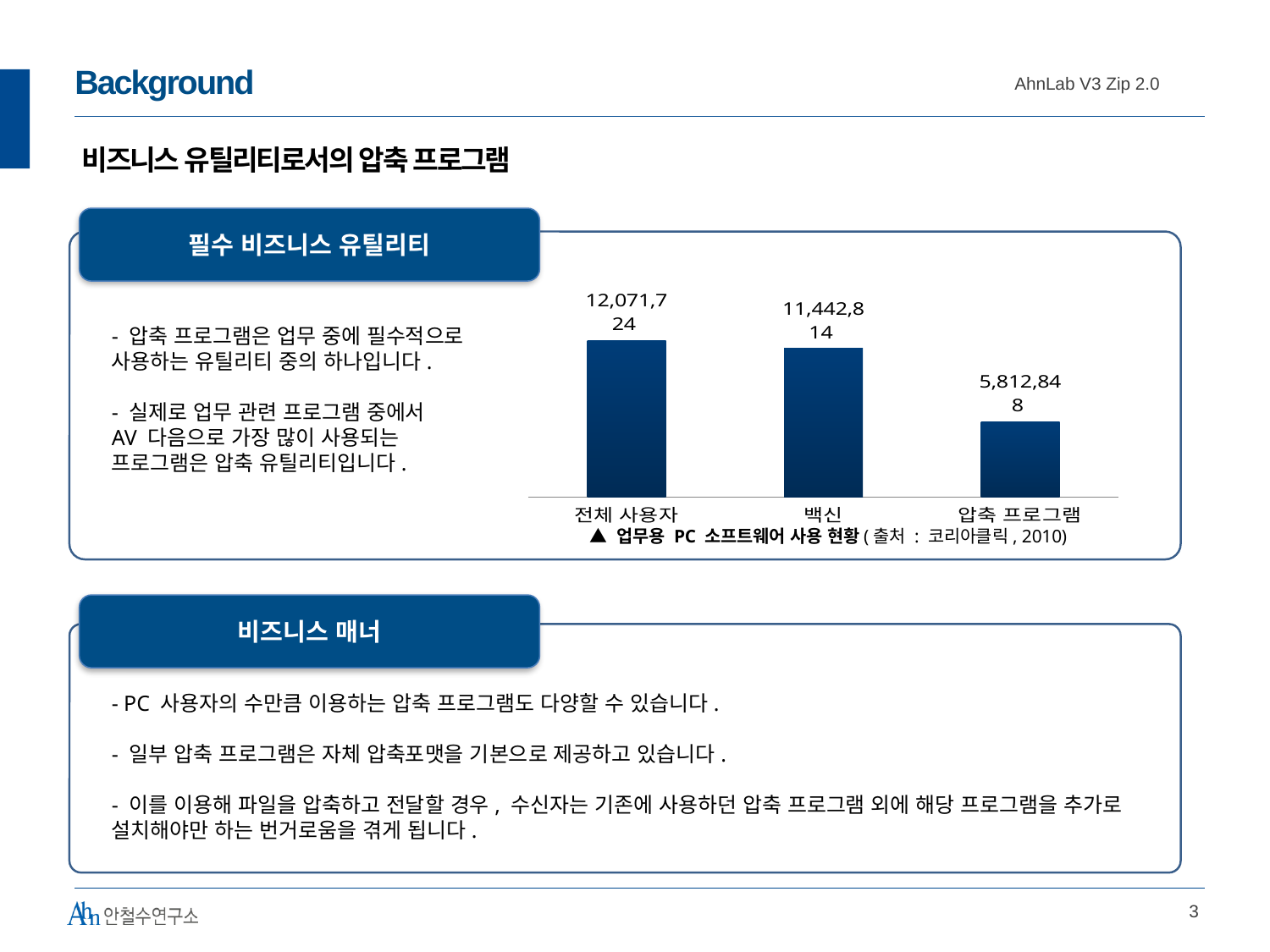
What kind of chart is shown on the slide? Bar chart What is the difference between the values for 백신 and 압축 프로그램? 5,629,966 What is the value for 압축 프로그램? 5,812,848 What is the value for 백신? 11,442,814 What is the difference between the values for 전체 사용자 and 백신? 628,910 Do the values rise or fall from left to right across the categories? Fall Which category has the lowest value? 압축 프로그램 Which is larger, the value for 백신 or the value for 압축 프로그램? 백신 Which category has the highest value? 전체 사용자 According to the chart caption, what is the source of the data? 코리아클릭, 2010 What is the value for 전체 사용자? 12,071,724 How many categories are shown in the chart? 3